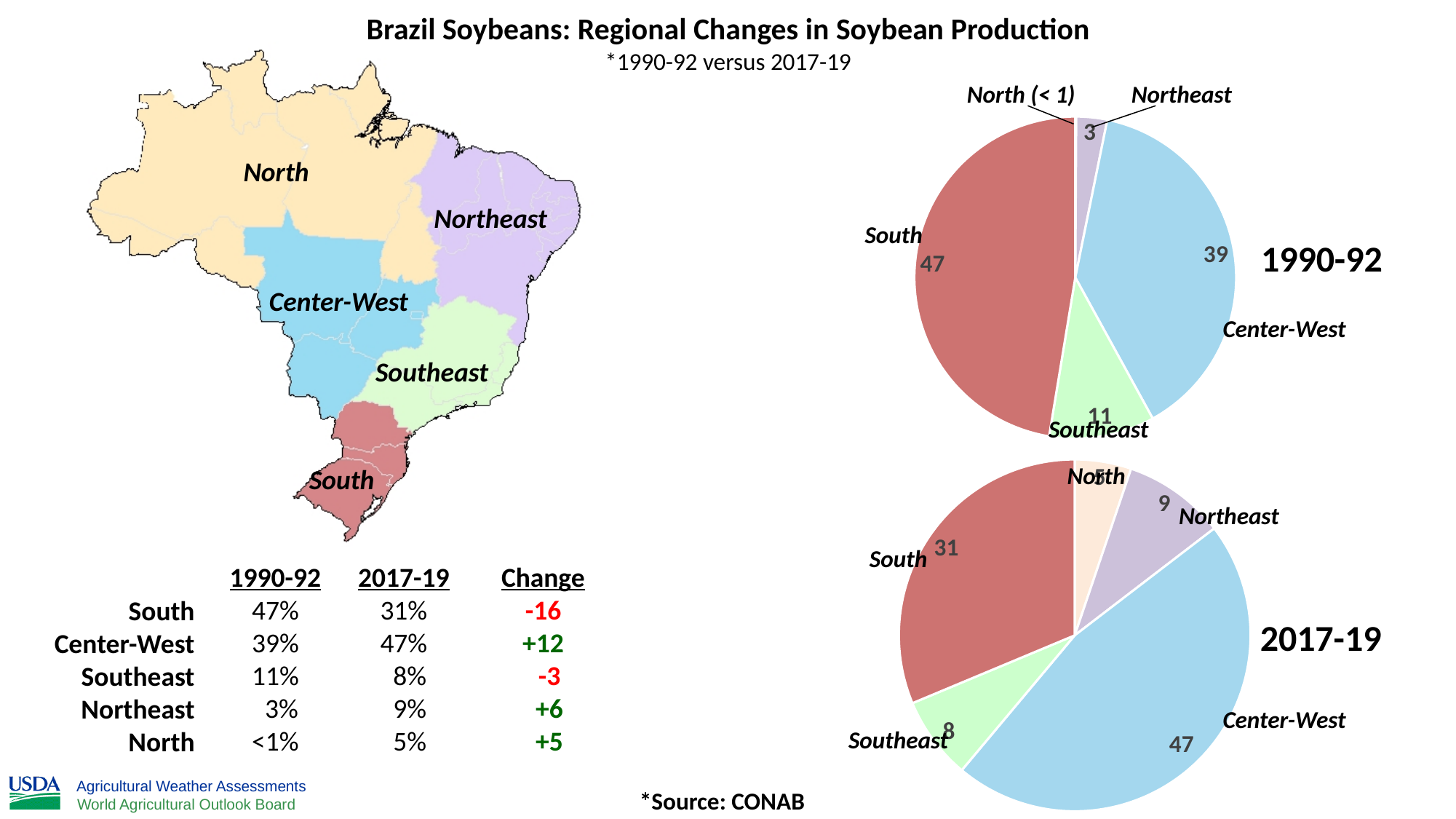
In the 1990-92 pie chart, which region has the largest slice? South In the 2017-19 pie chart, which region has the smallest slice? North In the 1990-92 pie chart, which is larger, the Southeast slice or the Northeast slice? Southeast In the 2017-19 pie chart, what is the value shown for North? 5 In the 2017-19 pie chart, what is the value shown for Northeast? 9 In the 1990-92 pie chart, what is the value shown for Center-West? 39 In the 2017-19 pie chart, which region has the largest slice? Center-West What type of chart is used to show the 1990-92 regional shares? Pie chart In the 1990-92 pie chart, what is the value shown for South? 47 How many regions are shown as slices in the 2017-19 pie chart? 5 In the 1990-92 pie chart, what colour is the Center-West slice? Light blue In the 2017-19 pie chart, what is the difference between the Center-West value and the South value? 16